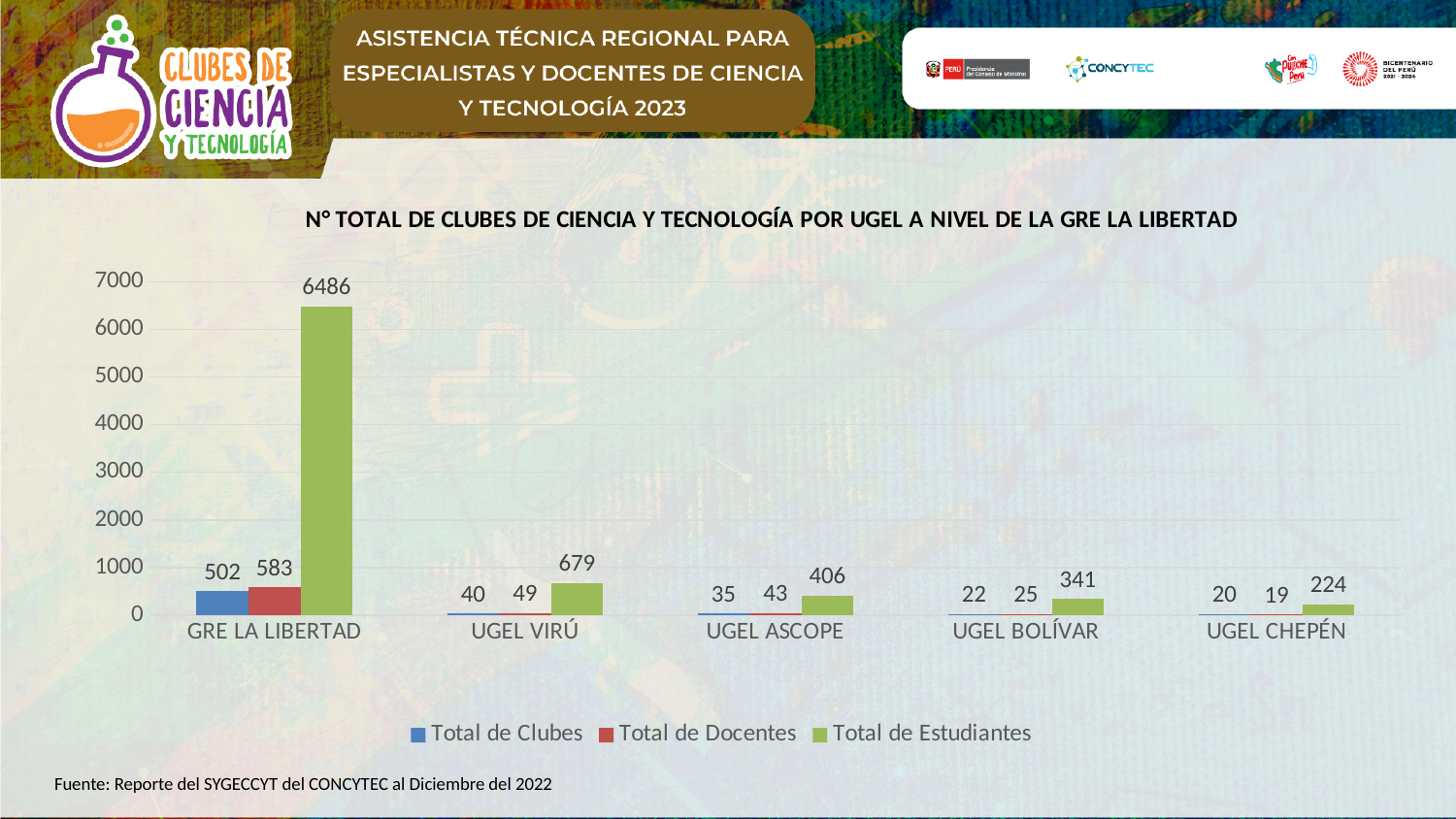
What is the difference between Total de Docentes and Total de Clubes for GRE LA LIBERTAD? 81 Is the Total de Estudiantes value for UGEL VIRÚ greater or less than 1000? less What is the Total de Docentes value for UGEL ASCOPE? 43 Which is larger for UGEL BOLÍVAR: Total de Clubes or Total de Docentes? Total de Docentes What kind of chart is shown on the slide? bar chart What is the Total de Estudiantes value for GRE LA LIBERTAD? 6486 Which category has the lowest Total de Clubes? UGEL CHEPÉN What is the Total de Clubes value for UGEL VIRÚ? 40 What is the Total de Estudiantes value for UGEL CHEPÉN? 224 How many categories are shown on the x axis? 5 Which category has the highest Total de Estudiantes? GRE LA LIBERTAD How many series does the legend list? 3